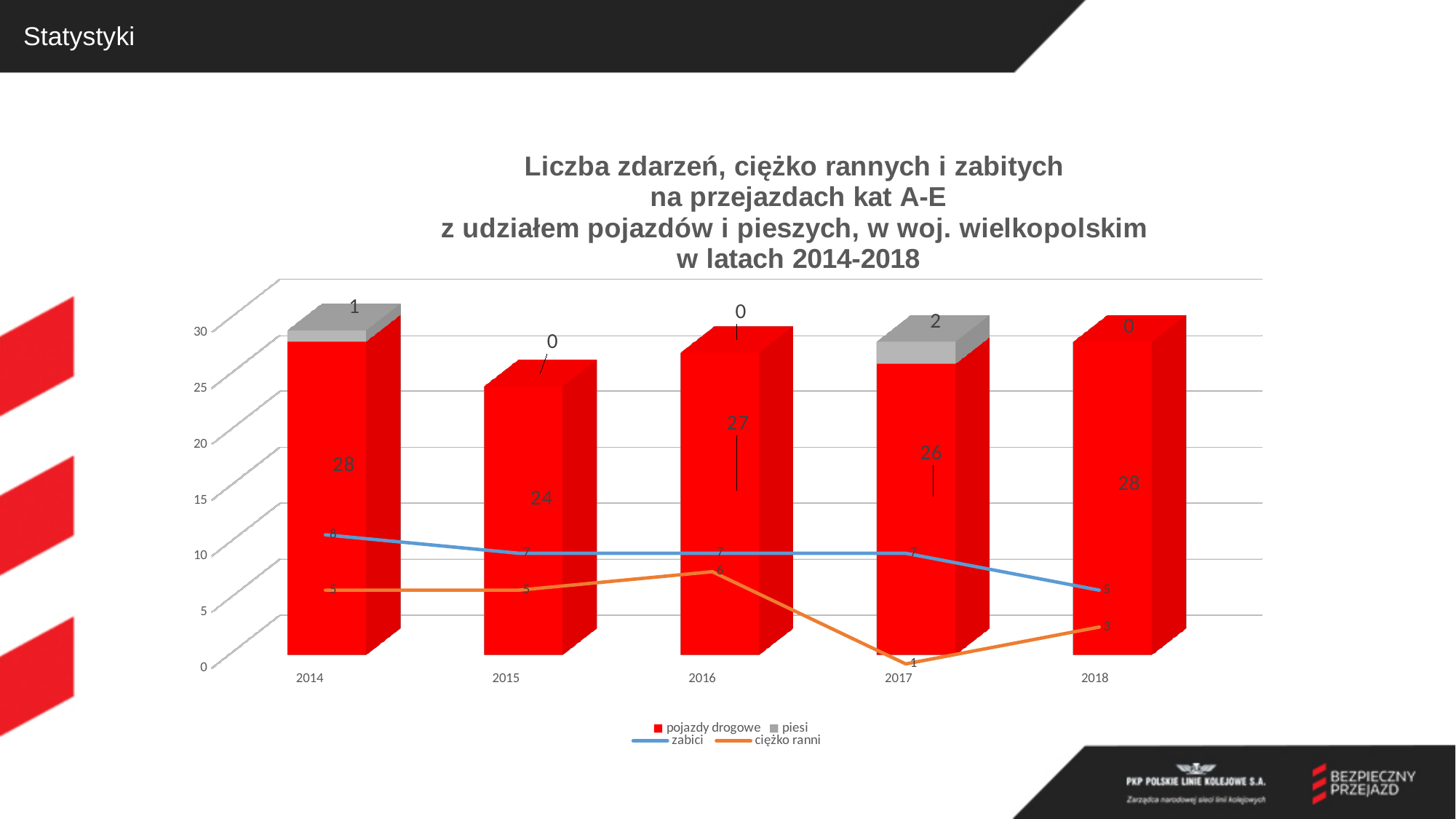
What is the total of the stacked bar for 2017? 28 Which is larger, the ciężko ranni value for 2016 or for 2018? 2016 What is the value for zabici in 2018? 5 Which year has the highest value for piesi? 2017 What is the difference between the pojazdy drogowe values for 2018 and 2015? 4 Which legend entry is shown in grey? piesi What is the value for piesi in 2017? 2 Which year has the lowest value for pojazdy drogowe? 2015 What is the value for ciężko ranni in 2017? 1 What is the value for pojazdy drogowe in 2016? 27 How many years are shown on the x axis? 5 How many series does the legend list? 4